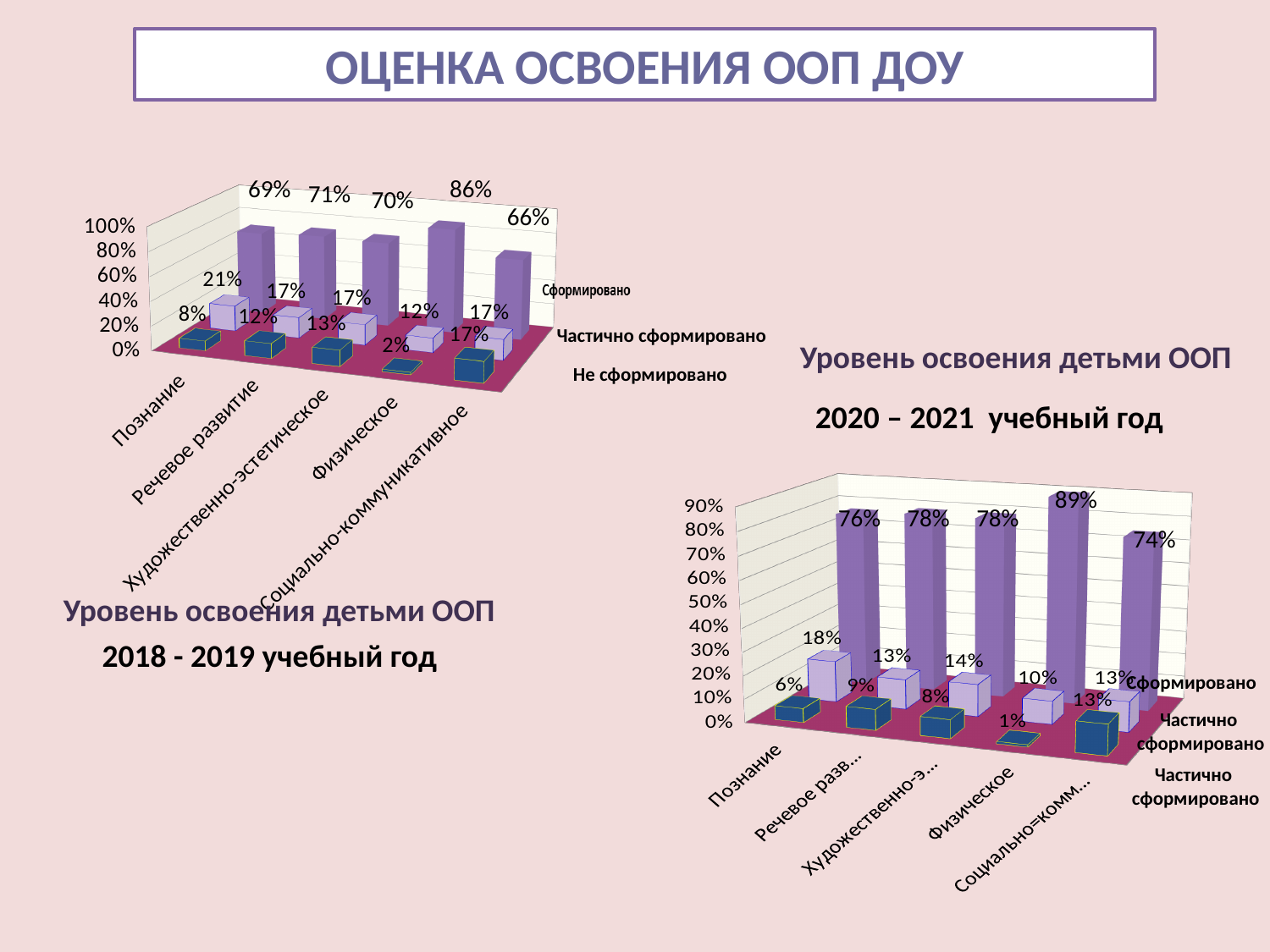
In the 2020 – 2021 chart, what is the value of the lowest bar for Физическое? 1% How many categories are shown on the x axis of the 2020 – 2021 chart? 5 In the 2020 – 2021 chart, which category has the lowest Сформировано value? Социально-коммуникативное In the 2020 – 2021 chart, which is larger: the Сформировано value for Физическое or for Познание? Физическое In the 2018 - 2019 chart, what is the value of Частично сформировано for Познание? 21% What type of chart is the 2020 – 2021 chart? Bar chart In the 2018 - 2019 chart, what is the difference between the Сформировано values for Физическое and Социально-коммуникативное? 20% In the 2018 - 2019 chart, which category has the highest Сформировано value? Физическое In the 2020 – 2021 chart, what is the value of Сформировано for Познание? 76% In the 2018 - 2019 chart, what is the value of the lowest bar for Физическое? 2% In the 2018 - 2019 chart, what is the value of Сформировано for Физическое? 86%